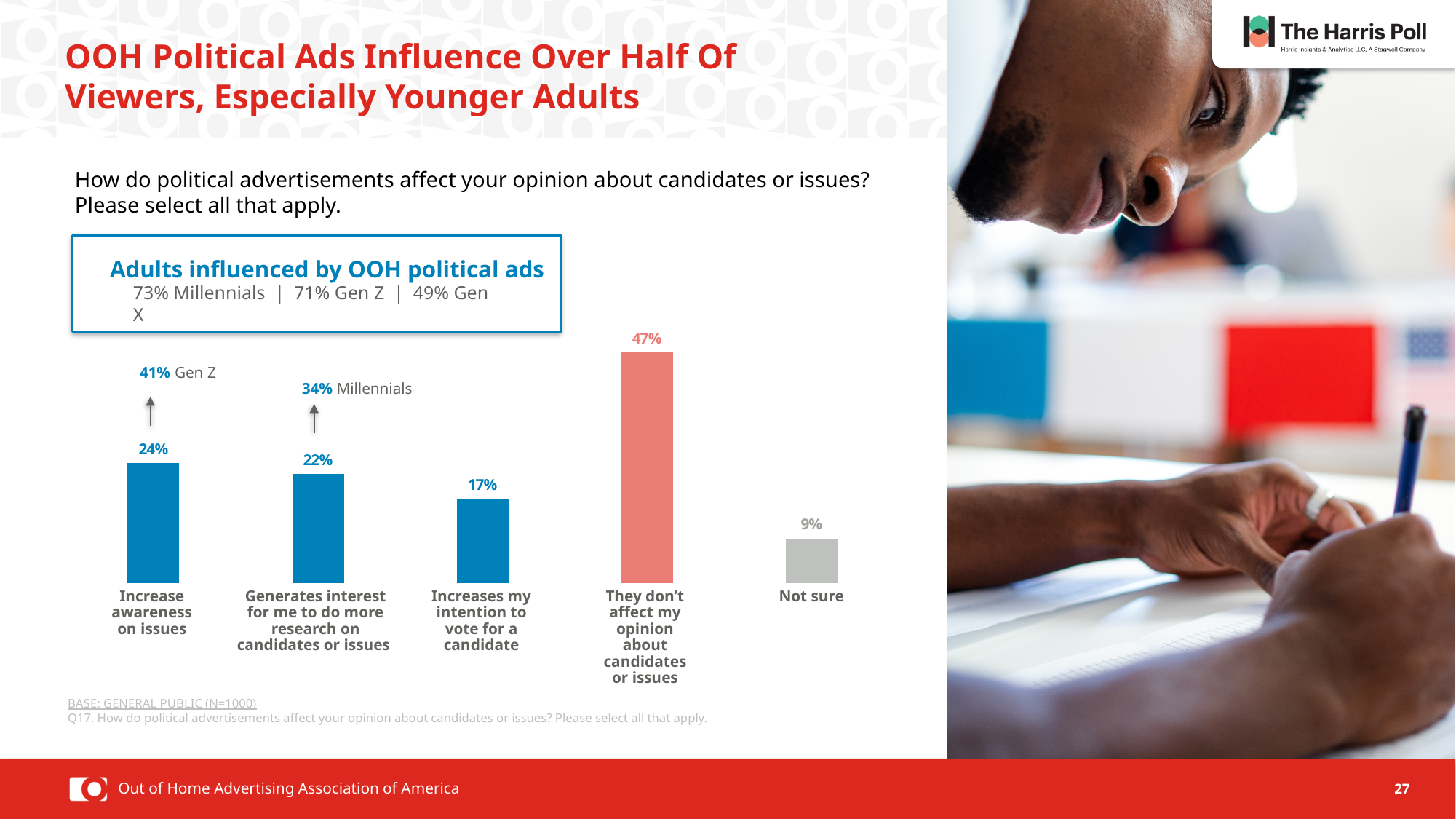
What percentage of respondents said political ads increase awareness on issues? 24% What kind of chart is shown on the slide? Bar chart What is the value for 'Generates interest for me to do more research on candidates or issues'? 22% What is the value for 'Not sure'? 9% How many categories are shown in the bar chart? 5 What is the difference between 'They don't affect my opinion about candidates or issues' and 'Increase awareness on issues'? 23 percentage points Which category has the highest value in the chart? They don't affect my opinion about candidates or issues What percentage said political ads increase their intention to vote for a candidate? 17% What percentage said political ads don't affect their opinion about candidates or issues? 47% Which is larger: 'Increase awareness on issues' or 'Increases my intention to vote for a candidate'? Increase awareness on issues What percentage of Gen Z respondents said political ads increase awareness on issues, according to the annotation above the first bar? 41% Which category has the lowest value in the chart? Not sure